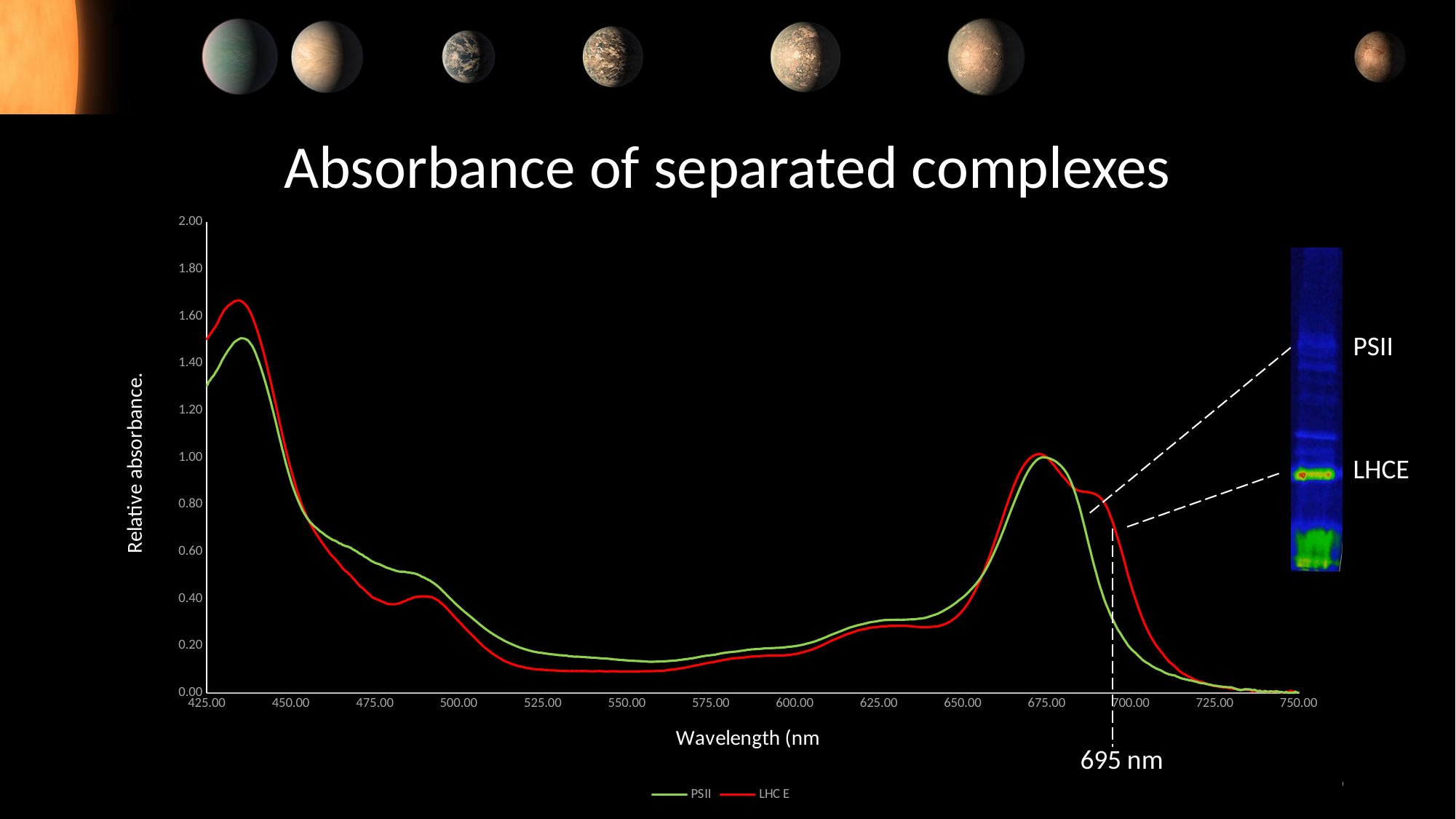
Which series reaches the highest absorbance value anywhere on the chart? LHC E Is the value of the PSII series at 695 nm greater or less than 0.60? less At 695 nm, which series has the higher absorbance, PSII or LHC E? LHC E Is the value of the PSII series at 550 nm greater or less than 0.20? less Is the peak value of the LHC E series near 435 nm greater or less than 1.40? greater How many series does the legend list? 2 What is the title of the chart? Absorbance of separated complexes At 475 nm, which series has the higher absorbance, PSII or LHC E? PSII What are the two series named in the legend? PSII and LHC E What kind of chart is shown on the slide? line chart Between 450 nm and 525 nm, do the absorbance values of both series rise or fall? fall